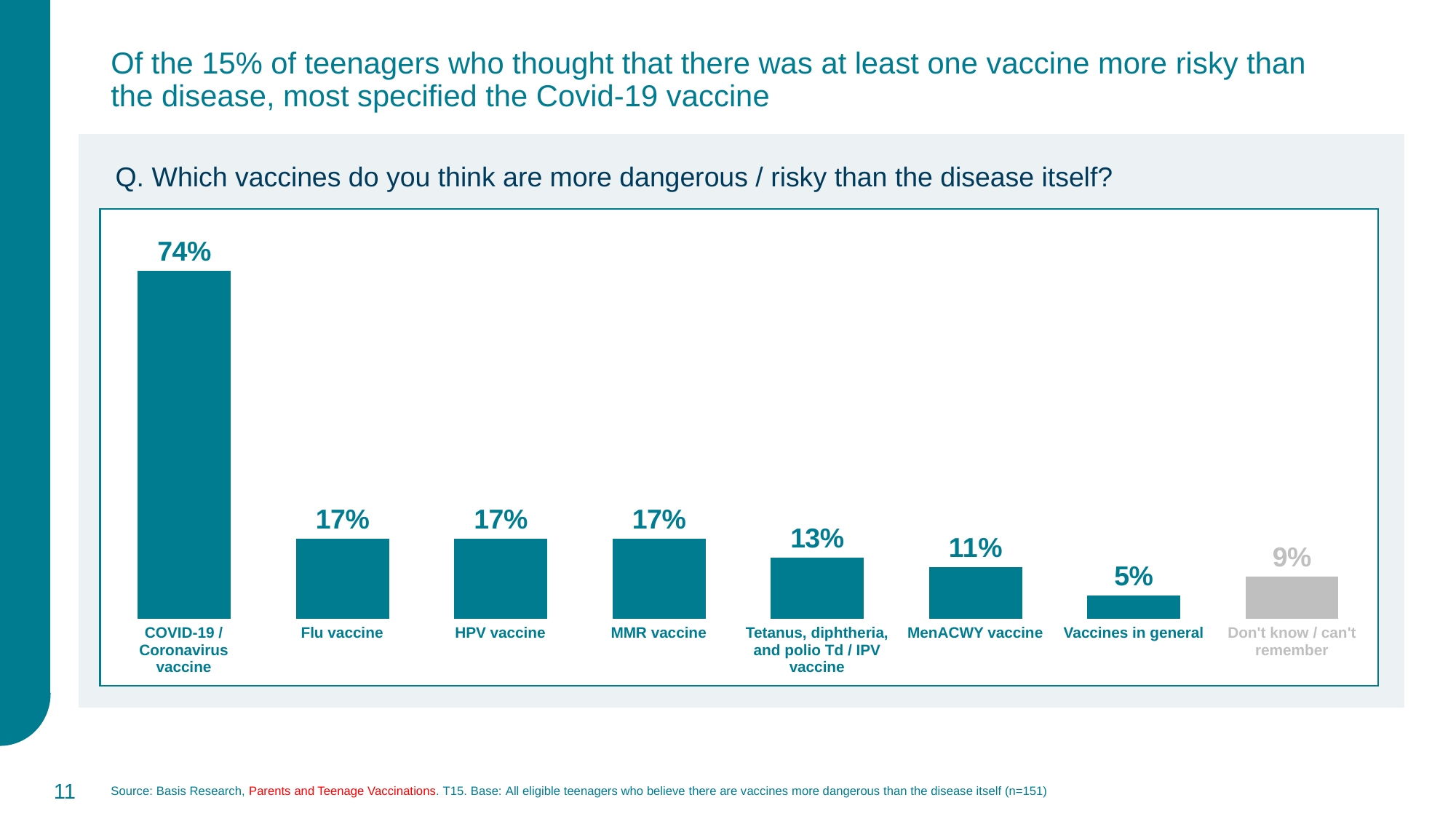
Which is larger, the value for the MenACWY vaccine or the value for 'Don't know / can't remember'? MenACWY vaccine What is the value for the Tetanus, diphtheria, and polio Td / IPV vaccine? 13% What kind of chart is shown on the slide? Bar chart Which bar is shown in grey rather than teal? Don't know / can't remember What is the value shown for the MenACWY vaccine? 11% Which category has the lowest value in the chart? Vaccines in general What percentage of teenagers named the COVID-19 / Coronavirus vaccine as more risky than the disease? 74% What percentage is shown for 'Vaccines in general'? 5% Which category has the highest value in the chart? COVID-19 / Coronavirus vaccine How many categories are shown in the chart? 8 What is the difference between the values for the HPV vaccine and the Tetanus, diphtheria, and polio Td / IPV vaccine? 4 percentage points What is the difference between the values for the COVID-19 / Coronavirus vaccine and the Flu vaccine? 57 percentage points